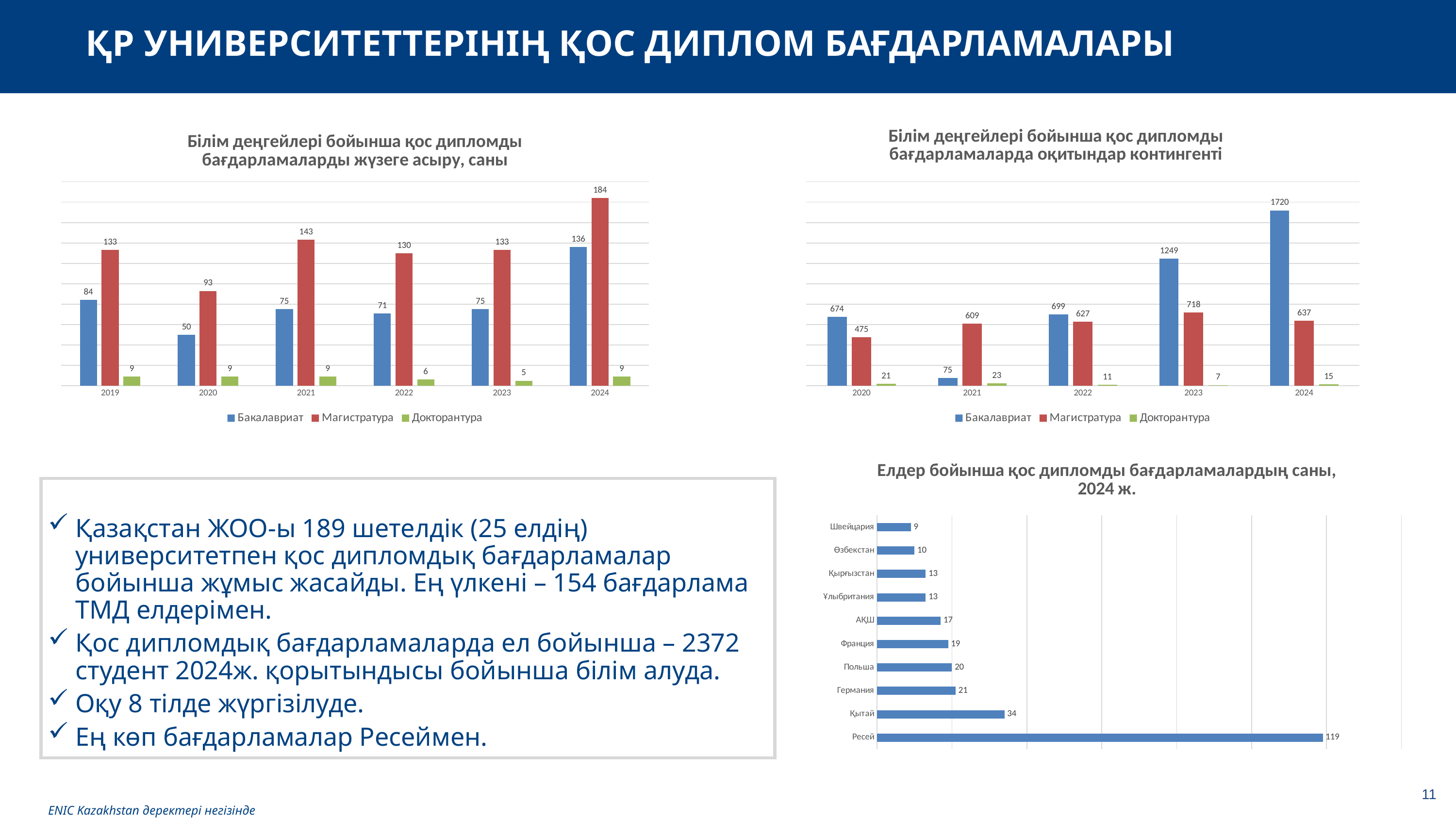
In the top-left chart (Білім деңгейлері бойынша қос дипломды бағдарламаларды жүзеге асыру, саны), what is the value for Бакалавриат in 2020? 50 In the top-right chart (Білім деңгейлері бойынша қос дипломды бағдарламаларда оқитындар контингенті), what is the total of the three series in 2023? 1974 In the top-right chart (Білім деңгейлері бойынша қос дипломды бағдарламаларда оқитындар контингенті), how many series does the legend list? 3 In the top-left chart (Білім деңгейлері бойынша қос дипломды бағдарламаларды жүзеге асыру, саны), what is the value for Магистратура in 2024? 184 In the top-right chart (Білім деңгейлері бойынша қос дипломды бағдарламаларда оқитындар контингенті), what is the value for Бакалавриат in 2024? 1720 In the top-left chart (Білім деңгейлері бойынша қос дипломды бағдарламаларды жүзеге асыру, саны), what is the difference between Магистратура and Бакалавриат in 2021? 68 In the top-left chart (Білім деңгейлері бойынша қос дипломды бағдарламаларды жүзеге асыру, саны), in which year is the Докторантура value lowest? 2023 In the bottom-right chart (Елдер бойынша қос дипломды бағдарламалардың саны, 2024 ж.), what is the value for Қытай? 34 In the bottom-right chart (Елдер бойынша қос дипломды бағдарламалардың саны, 2024 ж.), which country has the highest value? Ресей What kind of chart is the bottom-right chart (Елдер бойынша қос дипломды бағдарламалардың саны, 2024 ж.)? Bar chart In the top-left chart (Білім деңгейлері бойынша қос дипломды бағдарламаларды жүзеге асыру, саны), how many years are shown on the x axis? 6 In the top-right chart (Білім деңгейлері бойынша қос дипломды бағдарламаларда оқитындар контингенті), which is larger in 2021: Бакалавриат or Магистратура? Магистратура